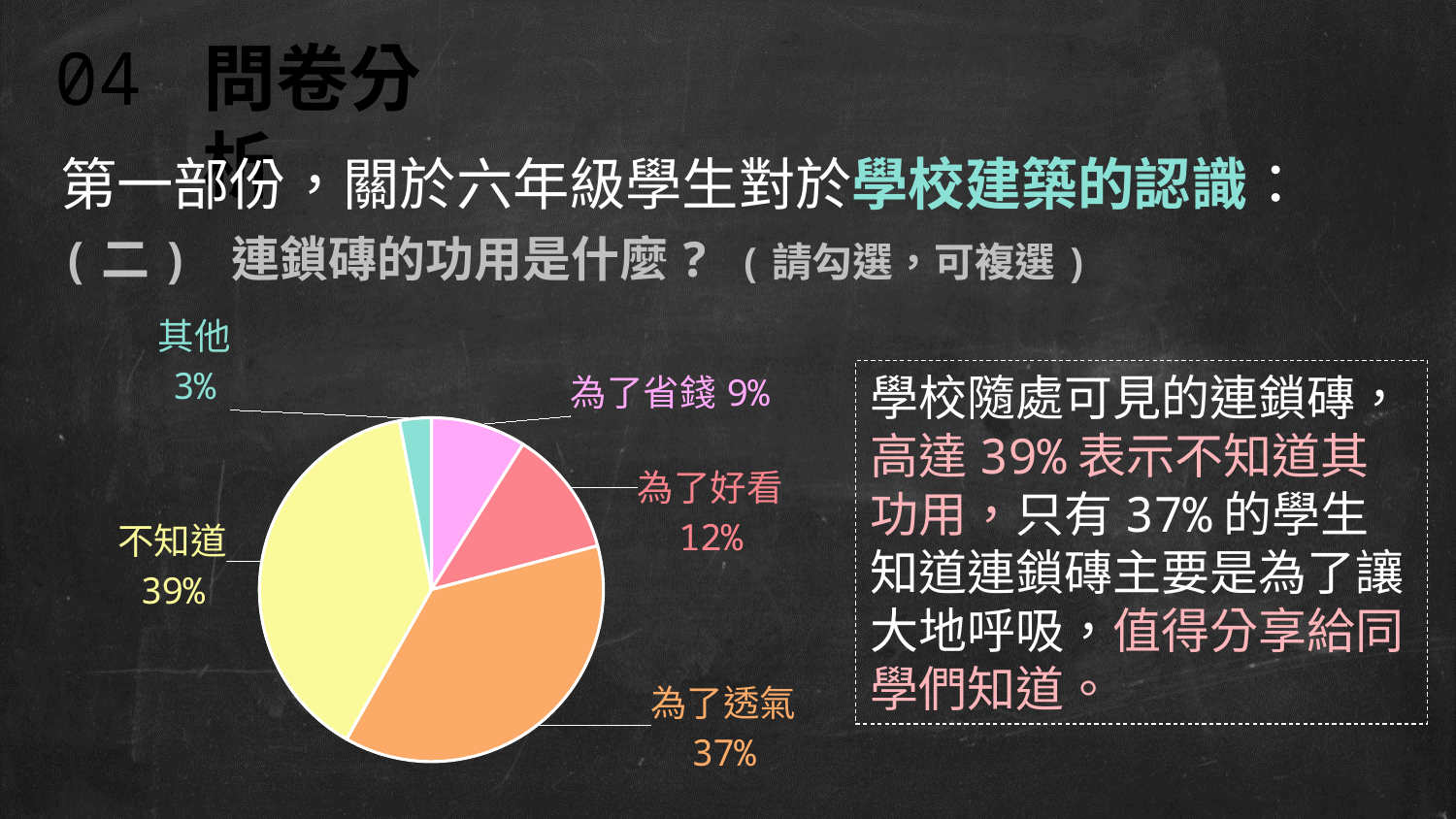
What colour is the slice for 不知道? yellow How many slices does the pie chart have? 5 What kind of chart is shown on the slide? pie chart Which category has the largest slice of the pie? 不知道 What share of the pie does 不知道 have? 39% What share of the pie does 為了好看 have? 12% What share of the pie does 其他 have? 3% Which category has the smallest slice of the pie? 其他 What is the difference between the shares for 為了好看 and 為了省錢? 3% Which is larger, the share for 為了透氣 or the share for 為了好看? 為了透氣